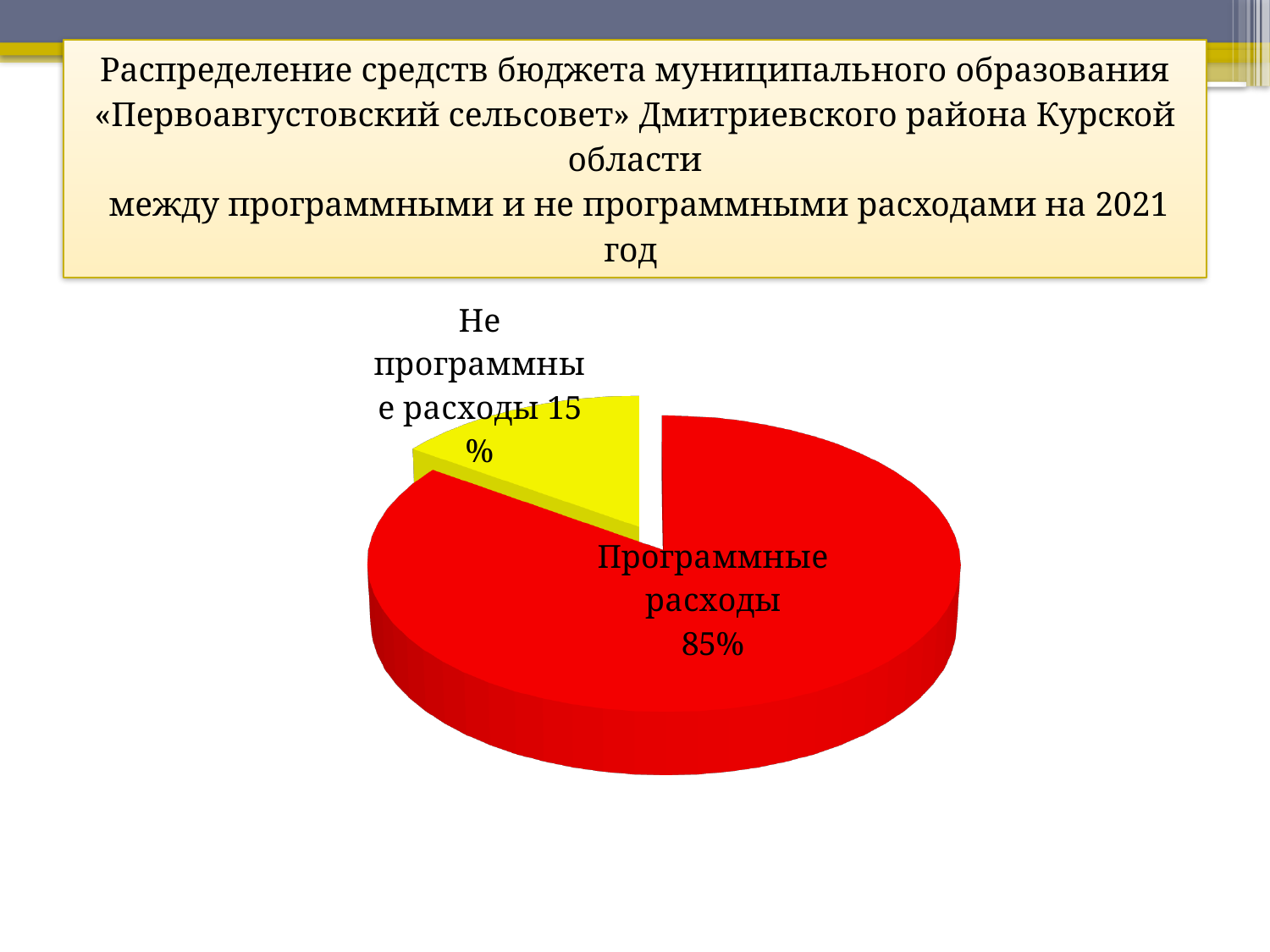
Which is larger: the share for "Программные расходы" or the share for "Не программные расходы"? Программные расходы What share of the pie is labelled "Программные расходы"? 85% Which slice of the pie is the smallest? Не программные расходы What is the total of the two slice percentages shown on the pie? 100% What colour is the "Программные расходы" slice? red What share of the pie is labelled "Не программные расходы"? 15% What kind of chart is shown on the slide? pie chart What colour is the "Не программные расходы" slice? yellow Which slice of the pie is the largest? Программные расходы How many slices does the pie chart have? 2 What is the difference in percentage points between the "Программные расходы" and "Не программные расходы" slices? 70